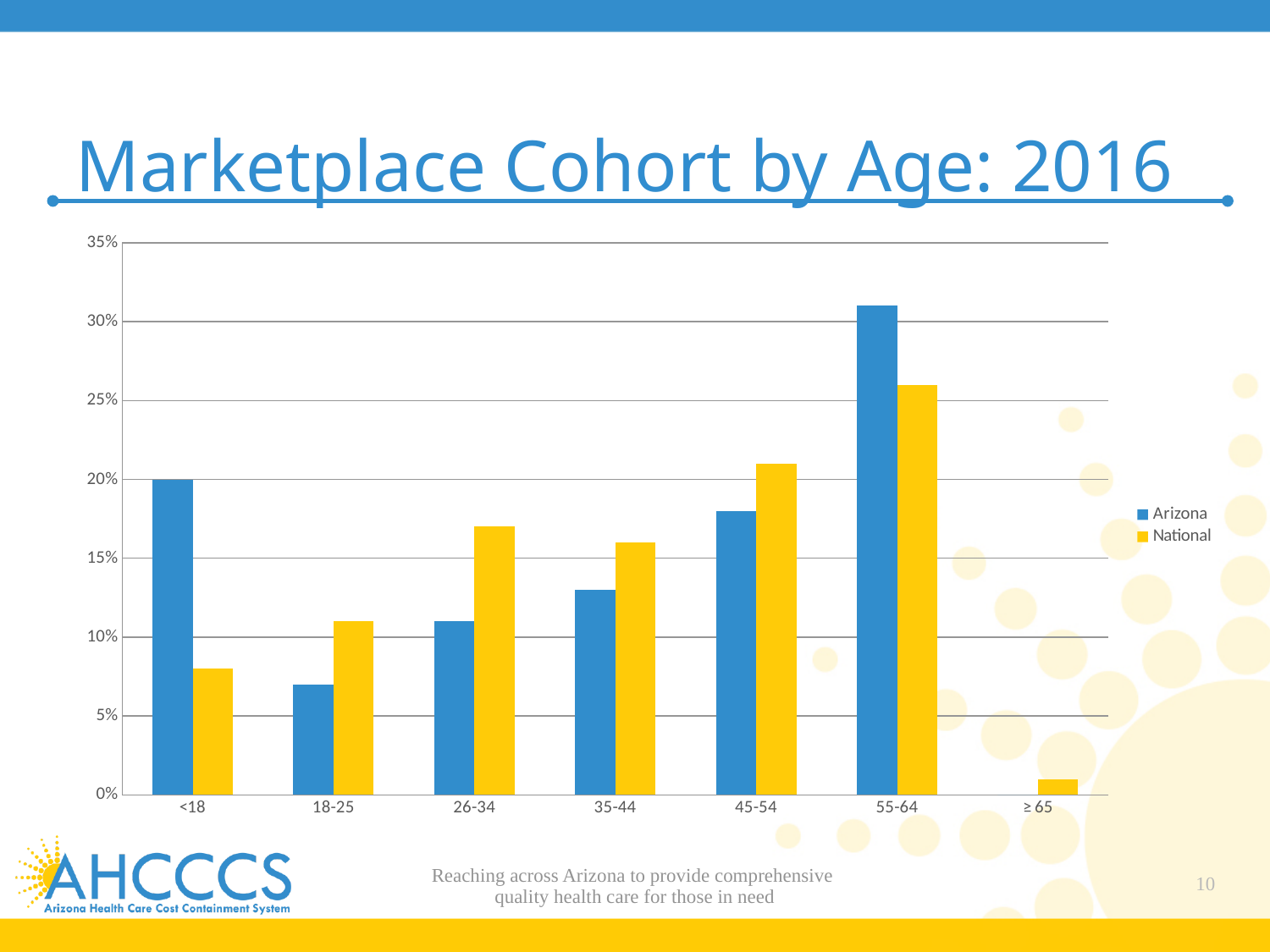
What is the title of the chart? Marketplace Cohort by Age: 2016 How many age categories are shown on the x axis? 7 Which age category has the lowest National value? ≥ 65 For the <18 category, which is larger, Arizona or National? Arizona Is the National value for 45-54 greater or less than 20%? greater Which age category has the highest National value? 55-64 For the 26-34 category, which is larger, Arizona or National? National Is the Arizona value for 55-64 greater or less than 30%? greater Which age category has the highest Arizona value? 55-64 How many series does the legend list? 2 Is the Arizona value for 18-25 greater or less than 10%? less What kind of chart is shown on the slide? Bar chart